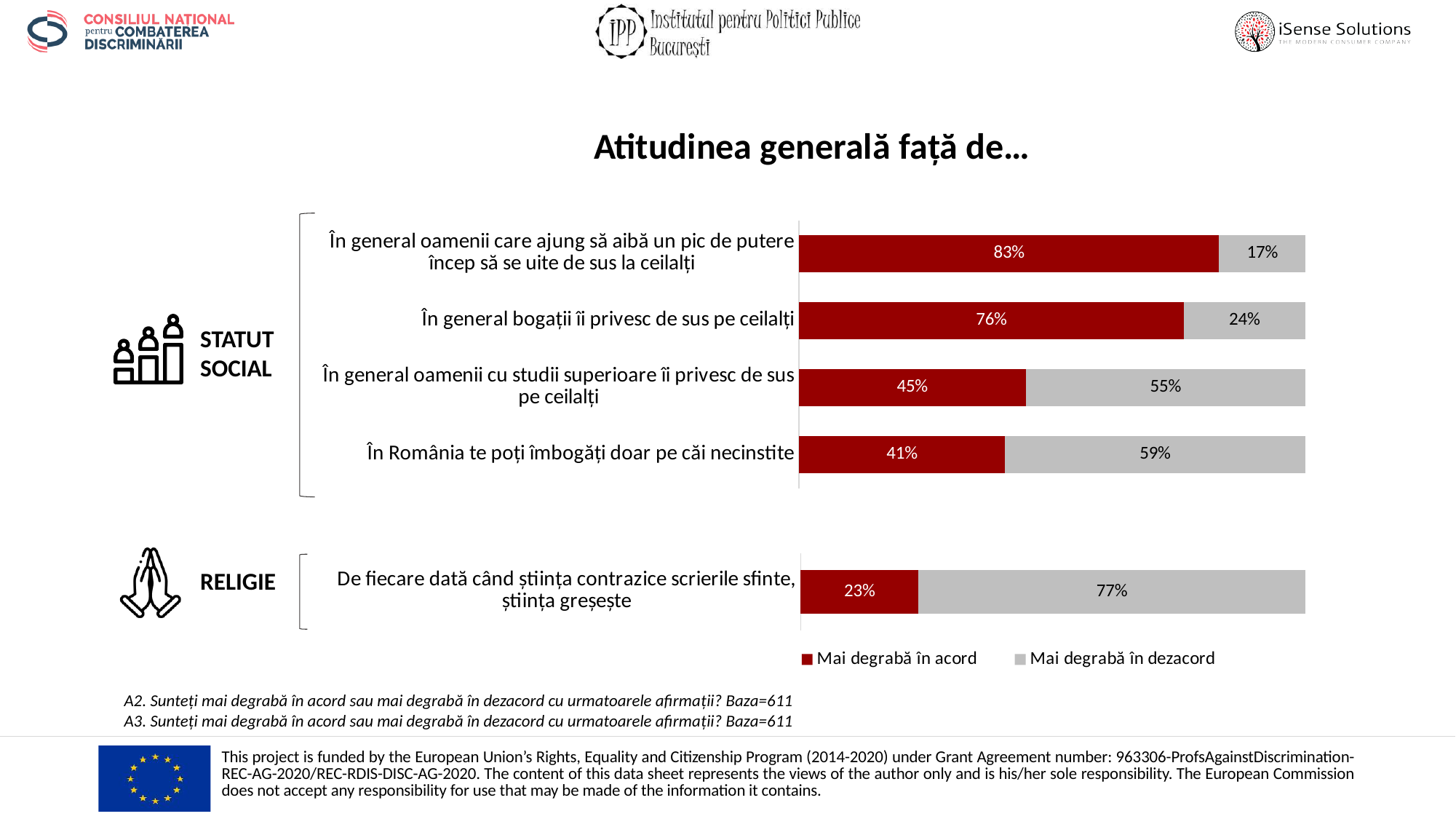
What is the total of the two segments in the bar for 'În general oamenii cu studii superioare îi privesc de sus pe ceilalți'? 100% How many statements (bars) are shown in the chart? 5 What share of respondents agree ('Mai degrabă în acord') that 'De fiecare dată când știința contrazice scrierile sfinte, știința greșește'? 23% Which statement has the lowest 'Mai degrabă în acord' percentage? De fiecare dată când știința contrazice scrierile sfinte, știința greșește How many series does the legend list? 2 What colour represents 'Mai degrabă în dezacord' in the chart? Grey What percentage of respondents are 'Mai degrabă în acord' with the statement 'În general bogații îi privesc de sus pe ceilalți'? 76% What is the 'Mai degrabă în dezacord' value for the statement 'În România te poți îmbogăți doar pe căi necinstite'? 59% Which is larger: the 'Mai degrabă în dezacord' value for 'În general bogații îi privesc de sus pe ceilalți' or for 'În general oamenii care ajung să aibă un pic de putere încep să se uite de sus la ceilalți'? În general bogații îi privesc de sus pe ceilalți What type of chart is shown on the slide? Stacked bar chart What is the difference between the 'Mai degrabă în acord' values for 'În general oamenii cu studii superioare îi privesc de sus pe ceilalți' and 'În România te poți îmbogăți doar pe căi necinstite'? 4% Which statement has the highest 'Mai degrabă în acord' percentage? În general oamenii care ajung să aibă un pic de putere încep să se uite de sus la ceilalți